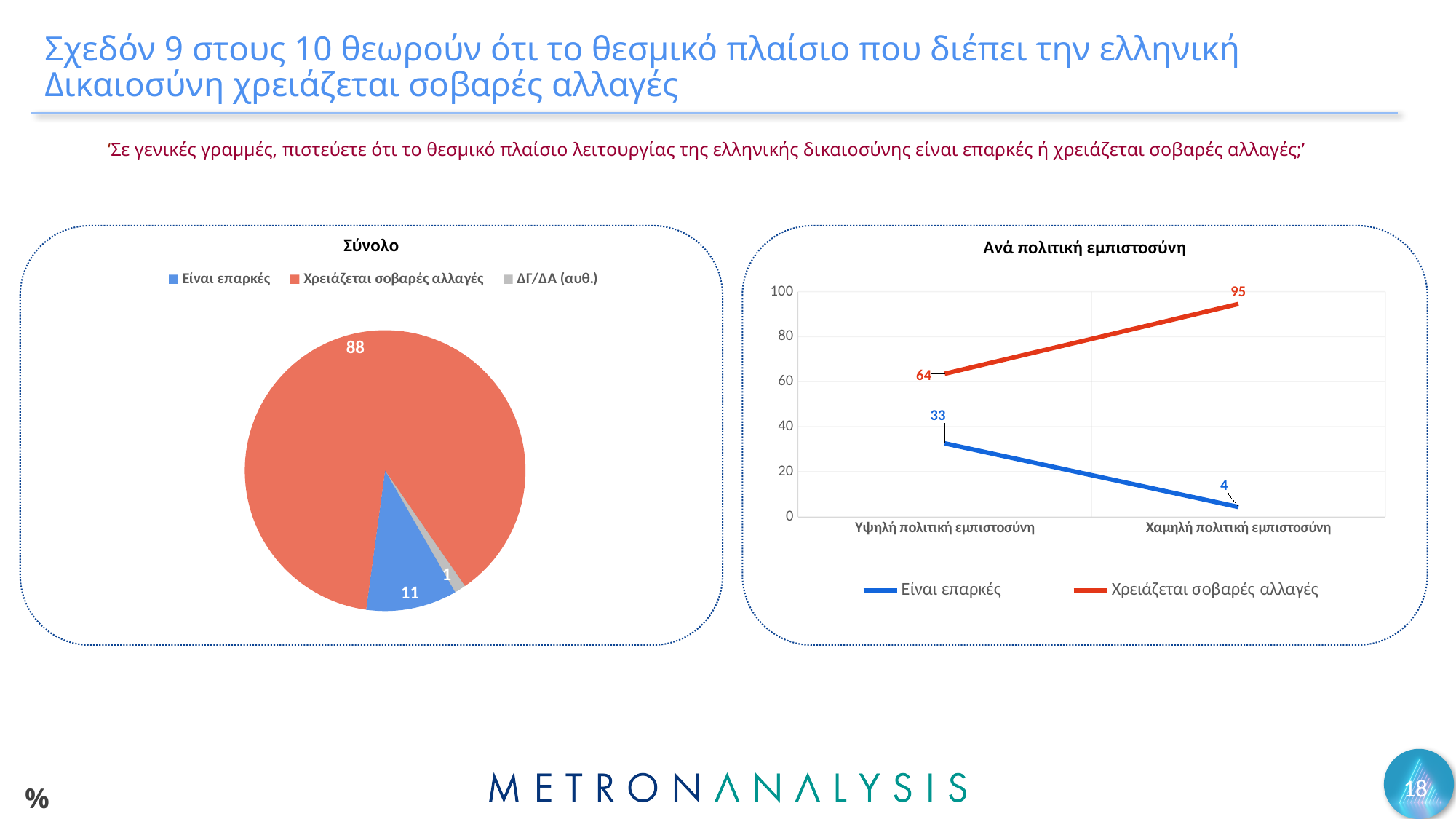
In the 'Ανά πολιτική εμπιστοσύνη' chart, which is larger for 'Υψηλή πολιτική εμπιστοσύνη': 'Είναι επαρκές' or 'Χρειάζεται σοβαρές αλλαγές'? Χρειάζεται σοβαρές αλλαγές In the 'Σύνολο' pie chart, what is the value for 'Χρειάζεται σοβαρές αλλαγές'? 88 In the 'Ανά πολιτική εμπιστοσύνη' chart, what is the value of 'Χρειάζεται σοβαρές αλλαγές' for 'Χαμηλή πολιτική εμπιστοσύνη'? 95 What kind of chart is the 'Σύνολο' chart? Pie chart In the 'Σύνολο' pie chart, how many slices are there? 3 In the 'Σύνολο' pie chart, what is the value for 'Είναι επαρκές'? 11 In the 'Ανά πολιτική εμπιστοσύνη' chart, how many series does the legend list? 2 In the 'Ανά πολιτική εμπιστοσύνη' chart, what is the difference between the 'Χρειάζεται σοβαρές αλλαγές' values for 'Χαμηλή πολιτική εμπιστοσύνη' and 'Υψηλή πολιτική εμπιστοσύνη'? 31 In the 'Ανά πολιτική εμπιστοσύνη' chart, does the 'Είναι επαρκές' line rise or fall from 'Υψηλή πολιτική εμπιστοσύνη' to 'Χαμηλή πολιτική εμπιστοσύνη'? Fall In the 'Σύνολο' pie chart, which category has the smallest slice? ΔΓ/ΔΑ (αυθ.) In the 'Ανά πολιτική εμπιστοσύνη' chart, what is the value of 'Είναι επαρκές' for 'Υψηλή πολιτική εμπιστοσύνη'? 33 What kind of chart is the 'Ανά πολιτική εμπιστοσύνη' chart? Line chart